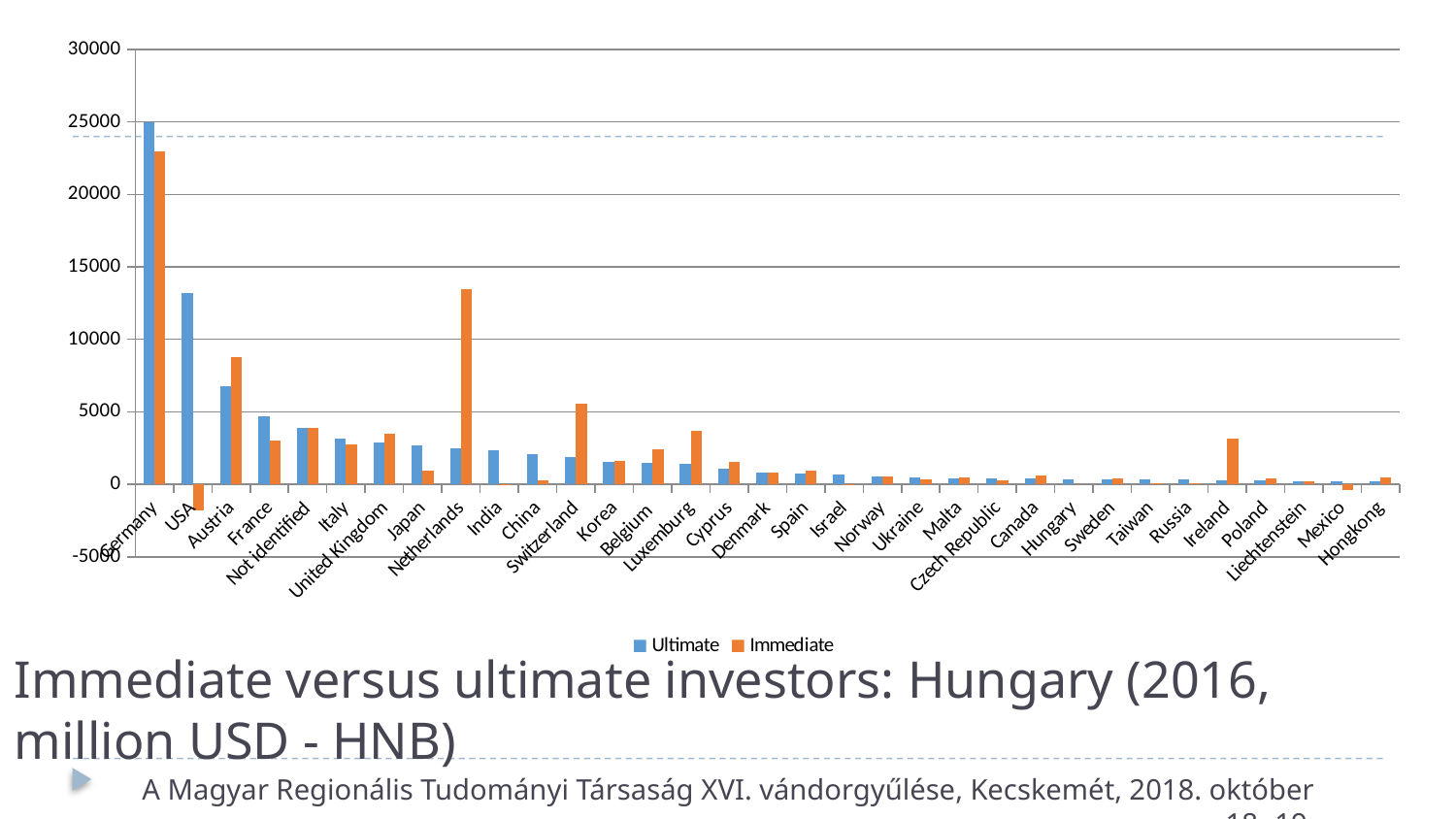
Which country has the highest Immediate value? Germany Is the Immediate value for the Netherlands greater or less than 10000? greater How many series does the legend list? 2 Which country has the highest Ultimate value? Germany Which country has the lowest Immediate value? USA Which series is shown in orange in the legend? Immediate Is the Ultimate value for Germany greater or less than 20000? greater For the Netherlands, which is larger: the Ultimate value or the Immediate value? Immediate What kind of chart is shown on the slide? bar chart For the USA, which is larger: the Ultimate value or the Immediate value? Ultimate Is the Immediate value for Ireland greater or less than 5000? less Do the Ultimate values generally rise or fall from left to right along the x axis? fall